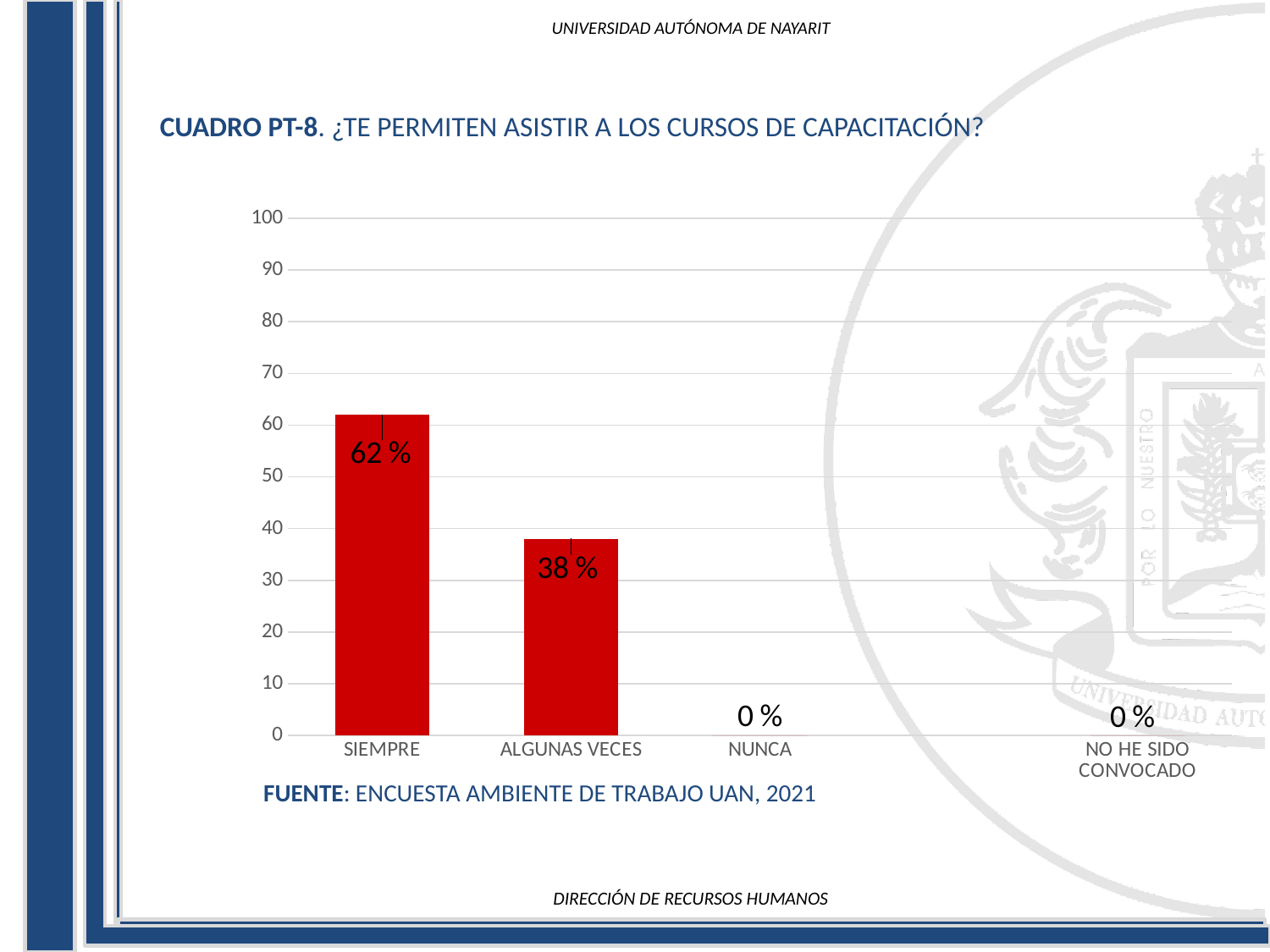
How many categories are shown on the x axis? 4 What is the value for ALGUNAS VECES? 38 % What is the difference between the values for SIEMPRE and ALGUNAS VECES? 24 % What kind of chart is shown on the slide? Bar chart Is the value for ALGUNAS VECES greater or less than 40? less What is the value for SIEMPRE? 62 % Which is larger, the value for SIEMPRE or the value for ALGUNAS VECES? SIEMPRE What is the value for NO HE SIDO CONVOCADO? 0 % Which category has the highest value? SIEMPRE Is the value for SIEMPRE greater or less than 50? greater What is the source cited below the chart? ENCUESTA AMBIENTE DE TRABAJO UAN, 2021 What is the value for NUNCA? 0 %